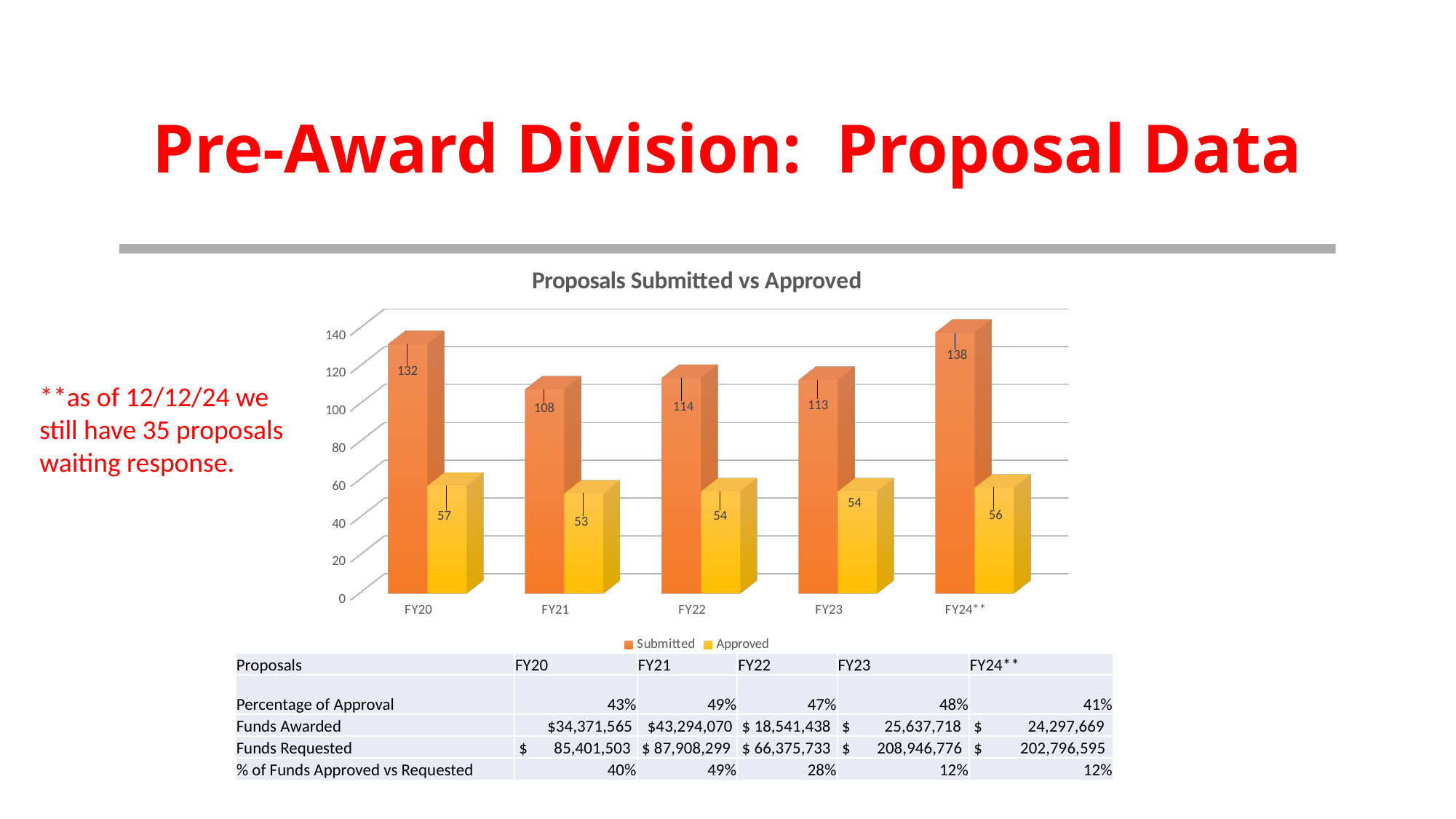
Which fiscal year has the lowest Submitted value? FY21 How many series does the legend list? 2 What is the value for Approved in FY21? 53 What is the title of the chart? Proposals Submitted vs Approved Which is larger, the Approved value in FY20 or the Approved value in FY23? FY20 What is the difference between Submitted and Approved in FY22? 60 How many fiscal years are shown on the x axis? 5 What is the value for Submitted in FY24**? 138 Which fiscal year has the highest Submitted value? FY24** What is the value for Submitted in FY20? 132 What kind of chart is shown? bar chart Is the Submitted value for FY23 greater or less than 100? greater